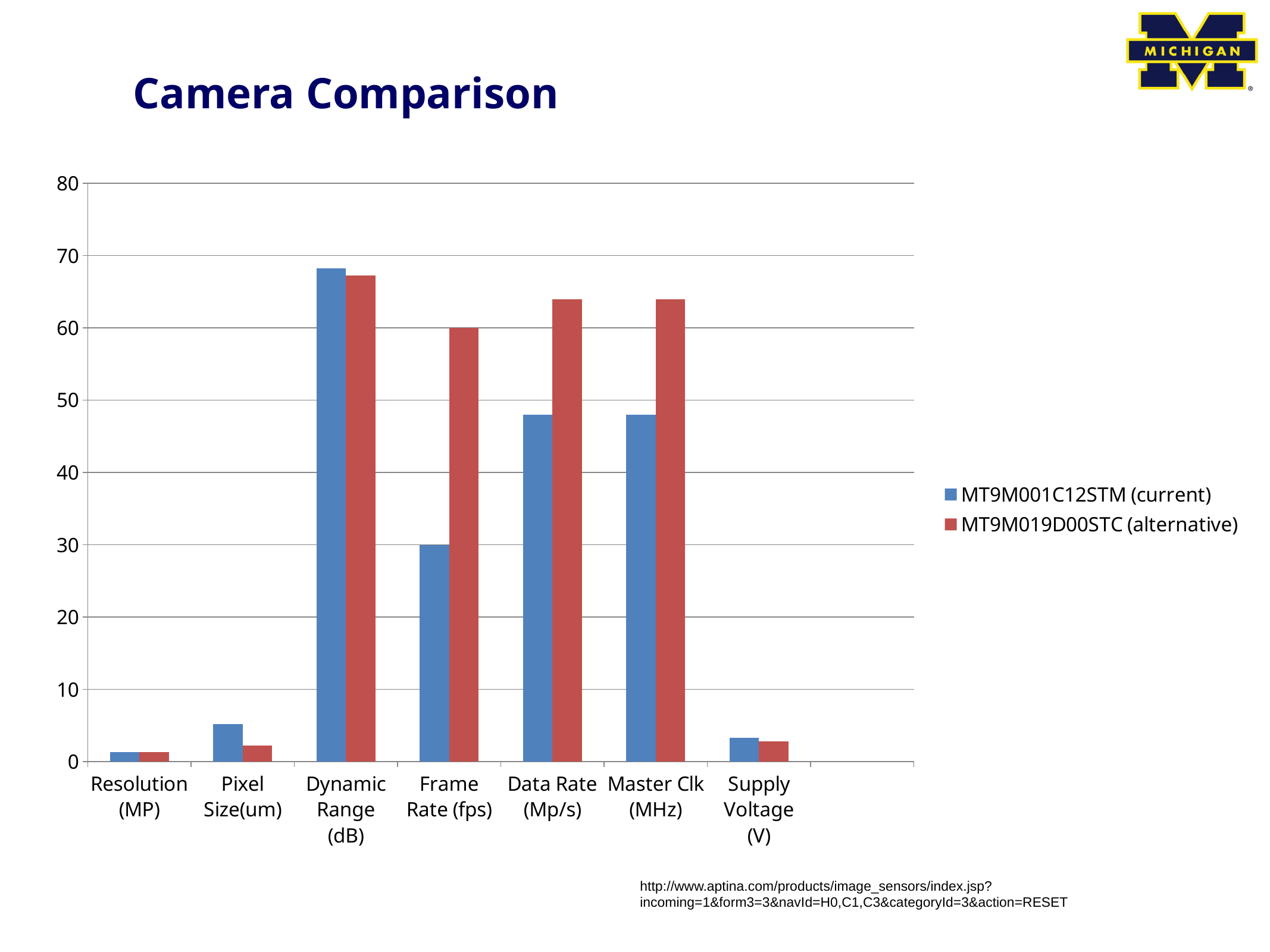
What is the difference in Frame Rate (fps) between MT9M019D00STC (alternative) and MT9M001C12STM (current)? 30 What is the Frame Rate (fps) value for MT9M001C12STM (current)? 30 Is the Master Clk (MHz) value for MT9M001C12STM (current) greater or less than 50? less How many series does the legend list? 2 How many categories are shown on the x axis? 7 For Data Rate (Mp/s), which series has the larger value? MT9M019D00STC (alternative) Which category has the lowest value for MT9M001C12STM (current)? Resolution (MP) Which category has the highest value for MT9M001C12STM (current)? Dynamic Range (dB) For Pixel Size(um), which series has the larger value? MT9M001C12STM (current) What kind of chart is shown on the slide? bar chart What is the Frame Rate (fps) value for MT9M019D00STC (alternative)? 60 Is the Data Rate (Mp/s) value for MT9M019D00STC (alternative) greater or less than 60? greater